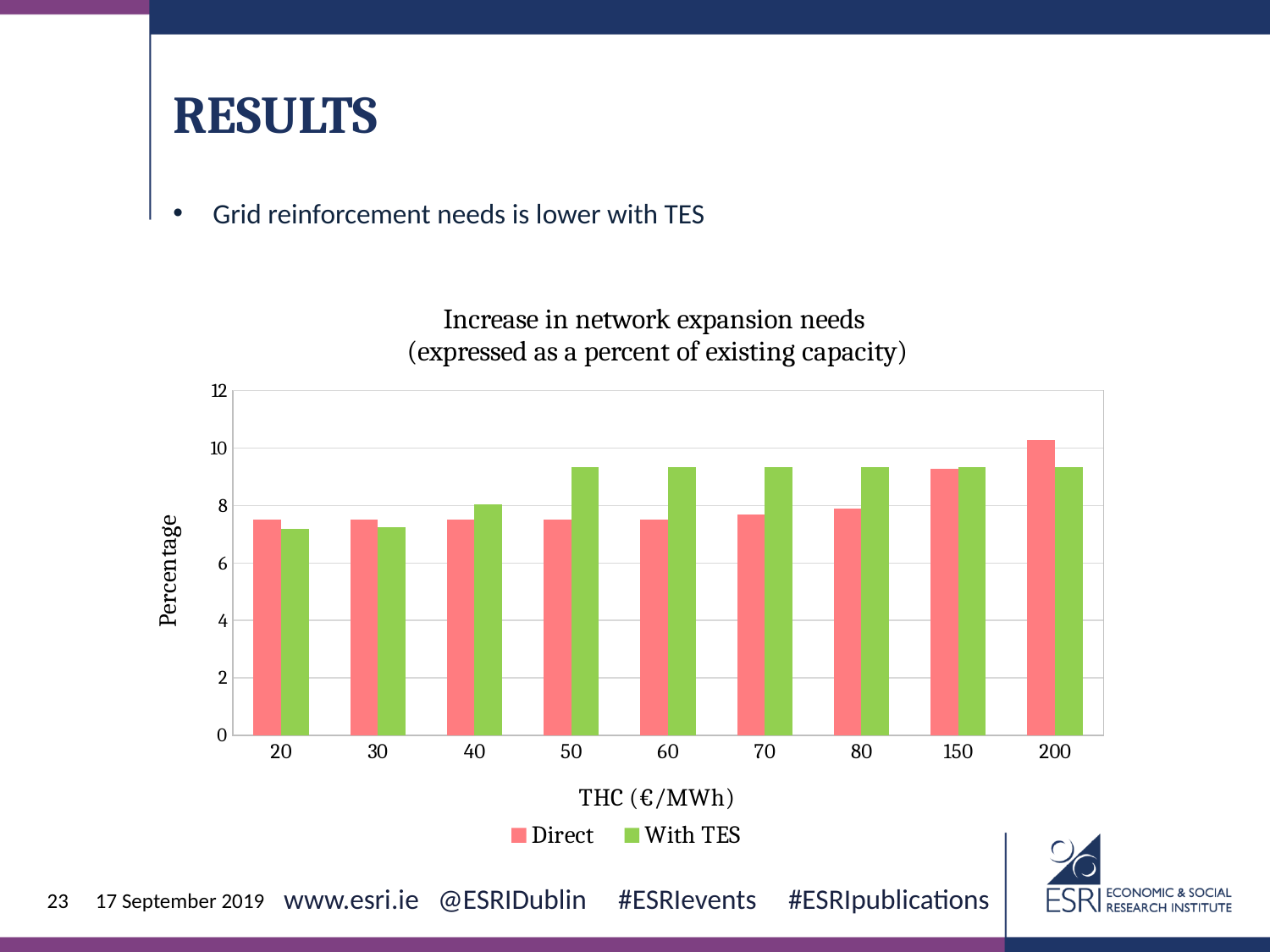
What kind of chart is shown on the slide? bar chart For which THC value is the Direct series highest? 200 Is the With TES value at a THC of 20 greater or less than 8? less What is the label on the y axis of the chart? Percentage How many THC categories are shown on the x axis? 9 Is the With TES value at a THC of 70 greater or less than 8? greater Is the Direct value at a THC of 200 greater or less than 8? greater At a THC of 200 €/MWh, which series has the larger value, Direct or With TES? Direct Do the Direct values generally rise or fall as THC increases along the x axis? rise At a THC of 50 €/MWh, which series has the larger value, Direct or With TES? With TES How many series does the legend list? 2